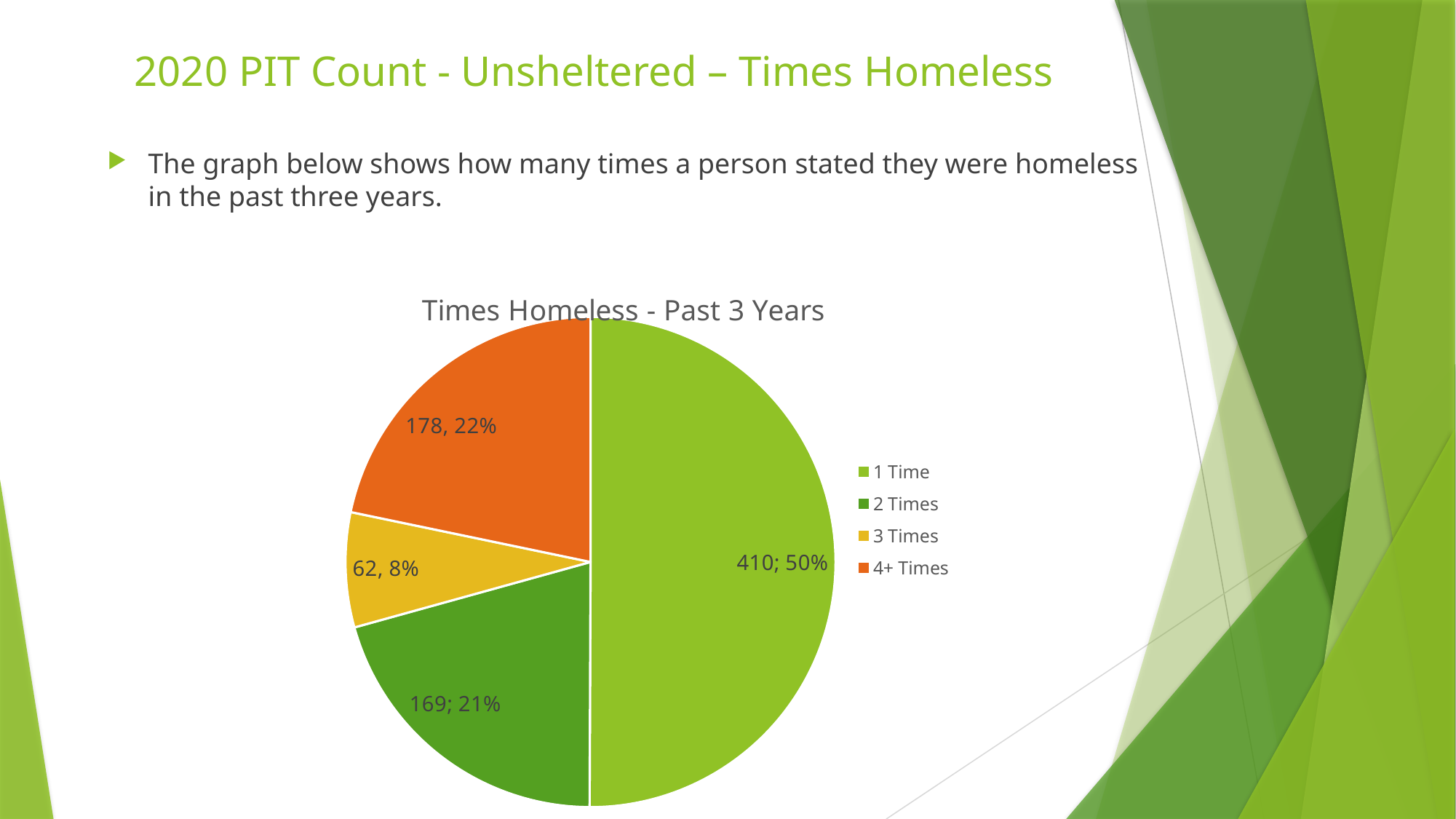
What is the count for the 2 Times slice? 169 What is the title of the chart? Times Homeless - Past 3 Years What is the count for the 1 Time slice? 410 What is the difference between the count for 1 Time and the count for 2 Times? 241 Which category has the largest slice? 1 Time What is the count for the 3 Times slice? 62 What percentage share does the 4+ Times slice have? 22% Which category has the smallest slice? 3 Times How many entries does the legend list? 4 How many slices does the pie chart have? 4 Which is larger, the count for 2 Times or the count for 4+ Times? 4+ Times What type of chart is shown on the slide? pie chart